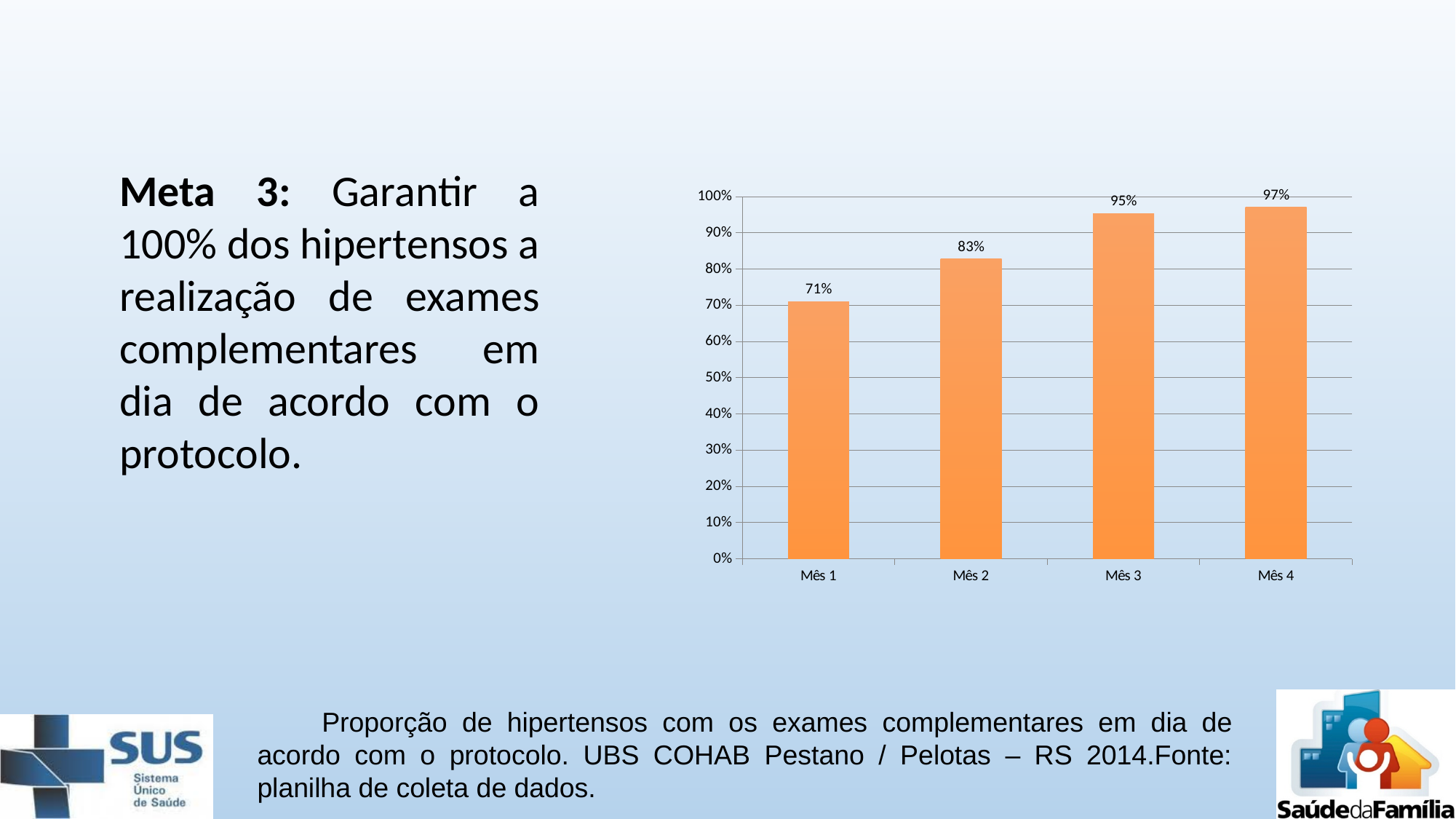
What is the difference between the values for Mês 2 and Mês 1? 12% What is the value for Mês 1? 71% Is the value for Mês 2 greater or less than 80%? greater Which is larger, the value for Mês 2 or the value for Mês 3? Mês 3 What kind of chart is shown on the slide? Bar chart Which month has the lowest value? Mês 1 Which month has the highest value? Mês 4 What is the value for Mês 3? 95% How many months are shown on the x axis? 4 What is the difference between the values for Mês 4 and Mês 3? 2% What is the value for Mês 4? 97% Do the values rise or fall from Mês 1 to Mês 4? Rise